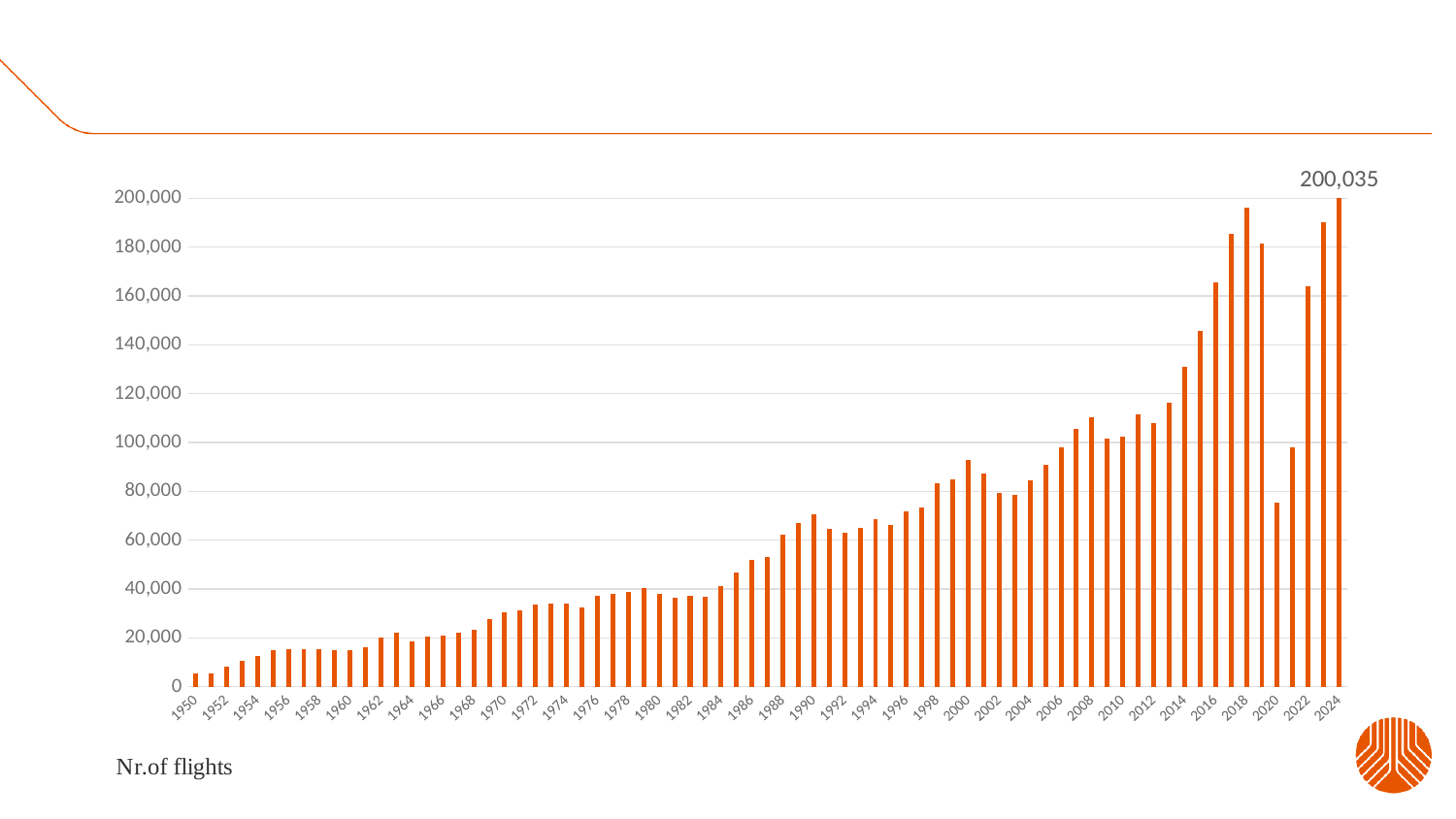
What kind of chart is shown on the slide? Bar chart What is the number of flights shown for 2024? 200,035 Is the value for 1970 greater or less than 20,000? greater Is the value for 2018 greater or less than 180,000? greater Which year has the highest number of flights? 2024 Do the values generally rise or fall from 1950 to 2024? Rise Is the value for 2000 greater or less than 80,000? greater What label appears below the chart describing the plotted quantity? Nr.of flights Which year has the larger value, 2022 or 2023? 2023 How many bars (years) are plotted in the chart? 75 Which year has the larger value, 2019 or 2020? 2019